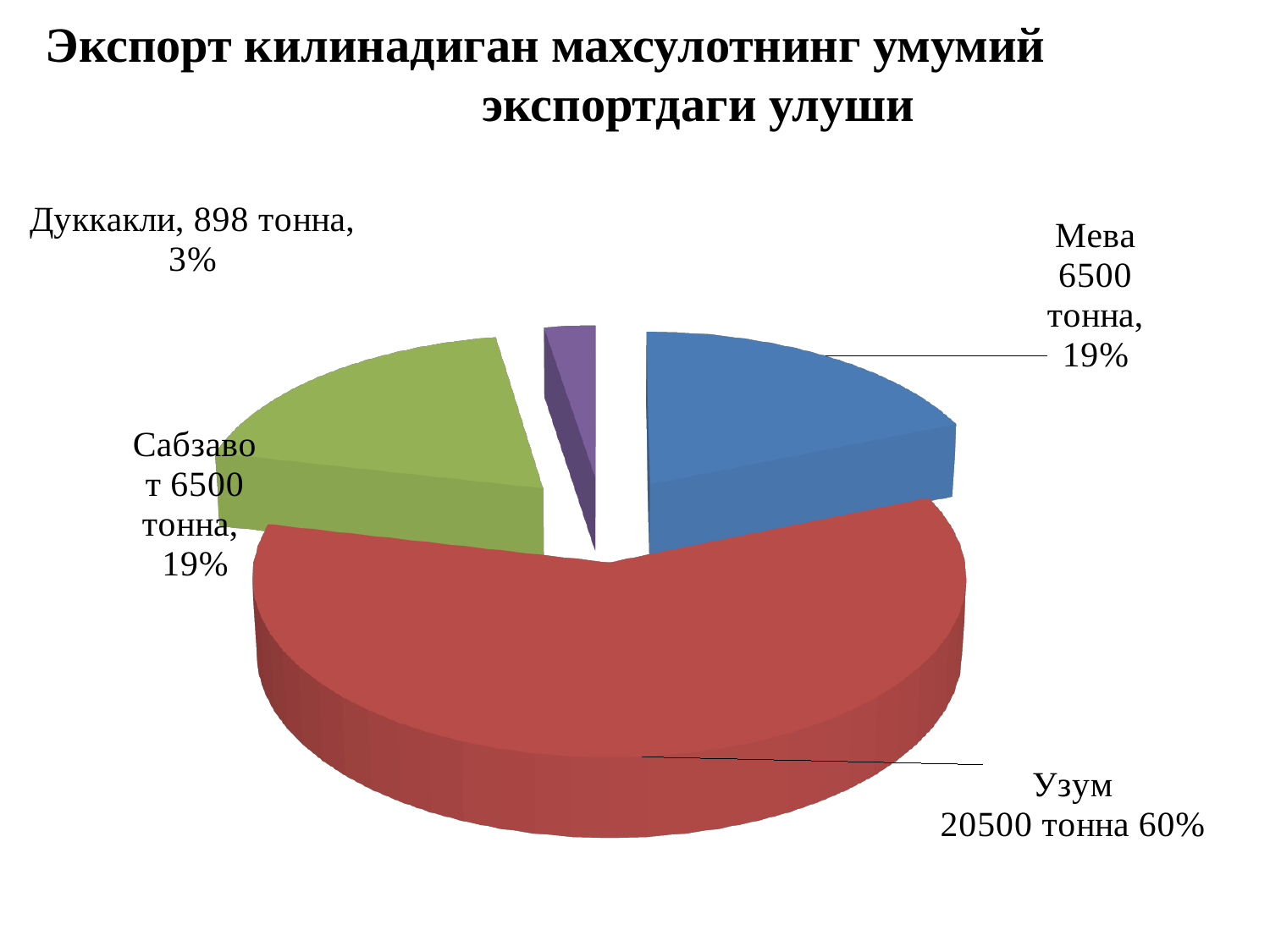
Which category has the largest share of the pie? Узум What colour is the Узум slice? red How many tonnes are shown for Дуккакли? 898 тонна What share of the pie does Мева have? 19% Which category has the smallest share of the pie? Дуккакли What kind of chart is shown on the slide? pie chart What share of the pie does Дуккакли have? 3% How many slices does the pie chart have? 4 How many tonnes are shown for Сабзавот? 6500 тонна How many tonnes are shown for Узум? 20500 тонна What is the difference in tonnes between Узум and Мева? 14000 тонна What share of the pie does Узум have? 60%